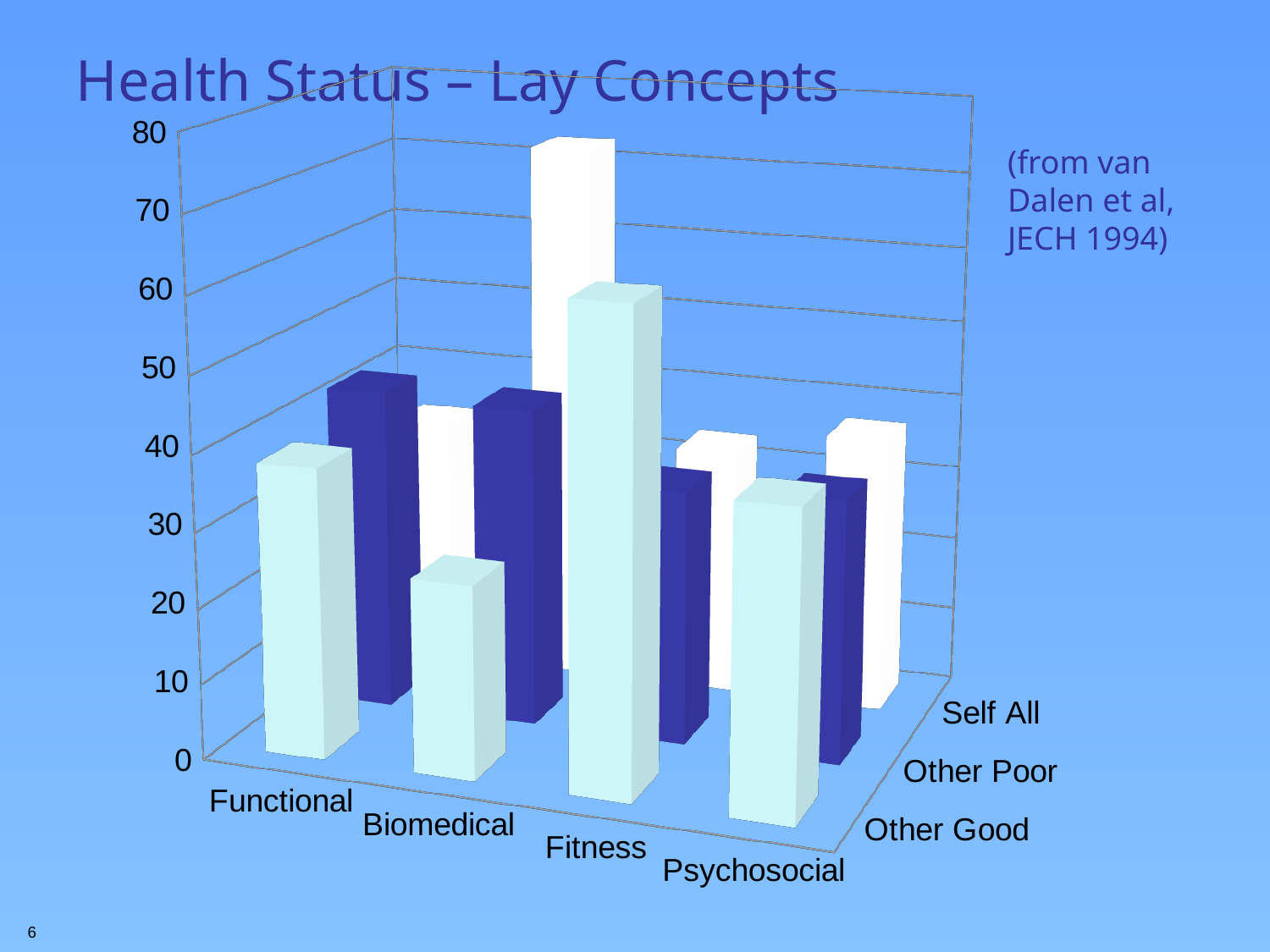
Which category has the tallest bar in the Self All series? Biomedical How many series (rows of bars) does the chart show? 3 Which category has the tallest bar in the Other Good series? Fitness In the Other Good series, which is larger: Functional or Biomedical? Functional What is the title of the chart slide? Health Status – Lay Concepts What source is cited for the chart data? van Dalen et al, JECH 1994 What kind of chart is shown on the slide? bar chart Which category has the shortest bar in the Other Good series? Biomedical Is the Self All value for Biomedical greater or less than 70? greater Is the Other Good value for Biomedical greater or less than 40? less Is the Other Good value for Fitness greater or less than 50? greater How many categories are shown along the front axis of the chart? 4